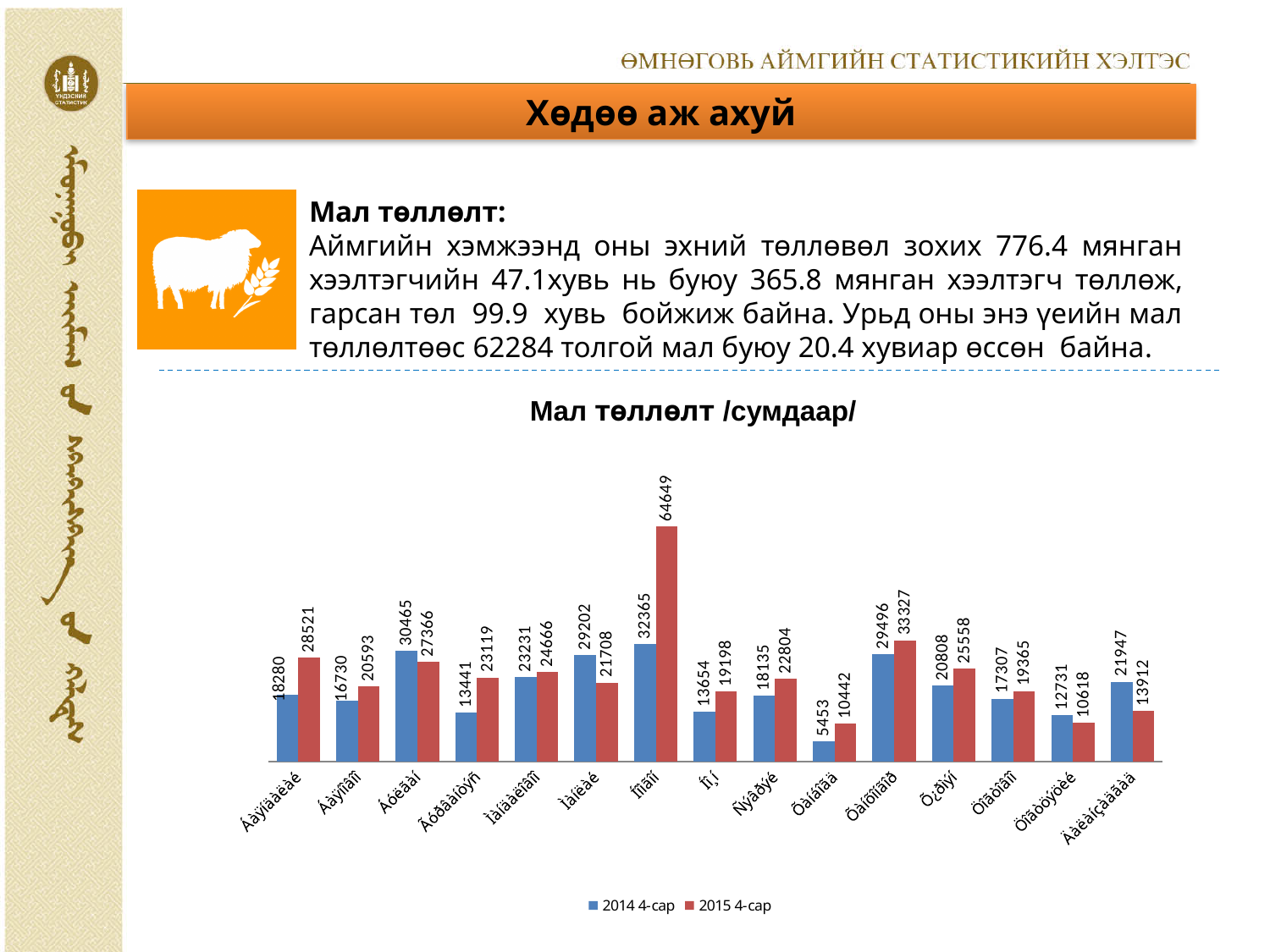
For the seventh category from the left (the one with the tallest bar), what is the difference between the 2015 4-сар value and the 2014 4-сар value? 32284 For the first category on the left, which series has the larger value, 2014 4-сар or 2015 4-сар? 2015 4-сар How many series does the legend of the chart list? 2 How many categories are plotted along the x axis of the chart? 15 What is the 2014 4-сар value for the third category from the left? 30465 What is the highest value shown on the chart? 64649 What kind of chart is shown under the title "Мал төллөлт /сумдаар/"? bar chart What is the lowest value shown on the chart? 5453 For the first category on the left, what is the difference between the 2015 4-сар value (28521) and the 2014 4-сар value (18280)? 10241 What is the lowest value in the "2015 4-сар" series? 10442 Which colour represents the "2015 4-сар" series in the chart? red What is the highest value in the "2014 4-сар" series? 32365